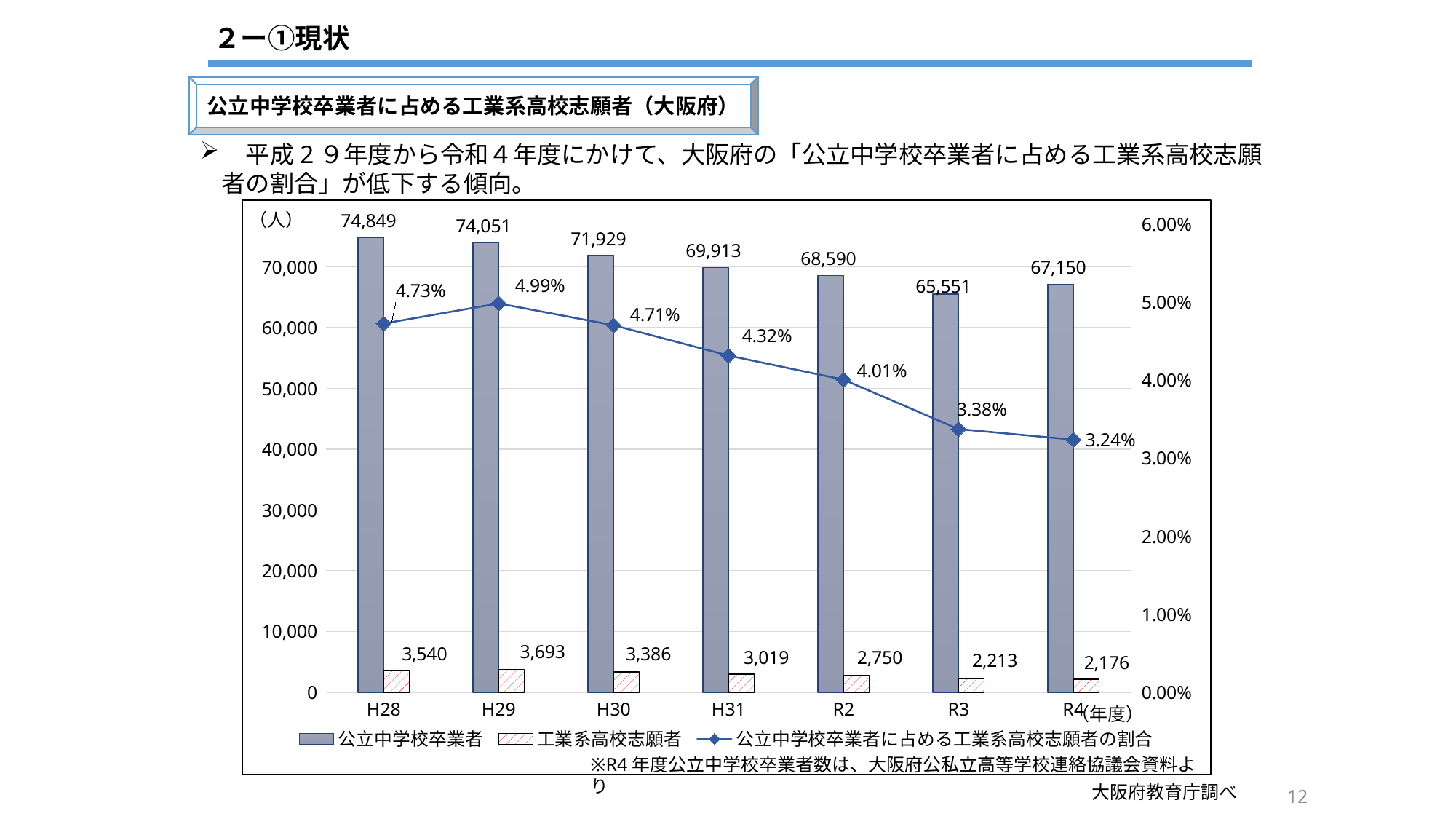
What is the value of 工業系高校志願者 for R2? 2,750 Which is larger, the 工業系高校志願者 value for H29 or for H30? H29 In which year is the 工業系高校志願者 value lowest? R4 What is the value of 公立中学校卒業者 for H28? 74,849 What kind of chart is this? Combined bar and line chart What is the 公立中学校卒業者に占める工業系高校志願者の割合 for H31? 4.32% What is the difference between the 公立中学校卒業者 values for H28 and R4? 7,699 How many years (categories) are shown on the x axis? 7 How many series does the legend list? 3 What is the unit label shown at the top of the left axis? （人） Does the 公立中学校卒業者に占める工業系高校志願者の割合 line rise or fall from H29 to R4? Fall In which year is the 公立中学校卒業者に占める工業系高校志願者の割合 highest? H29